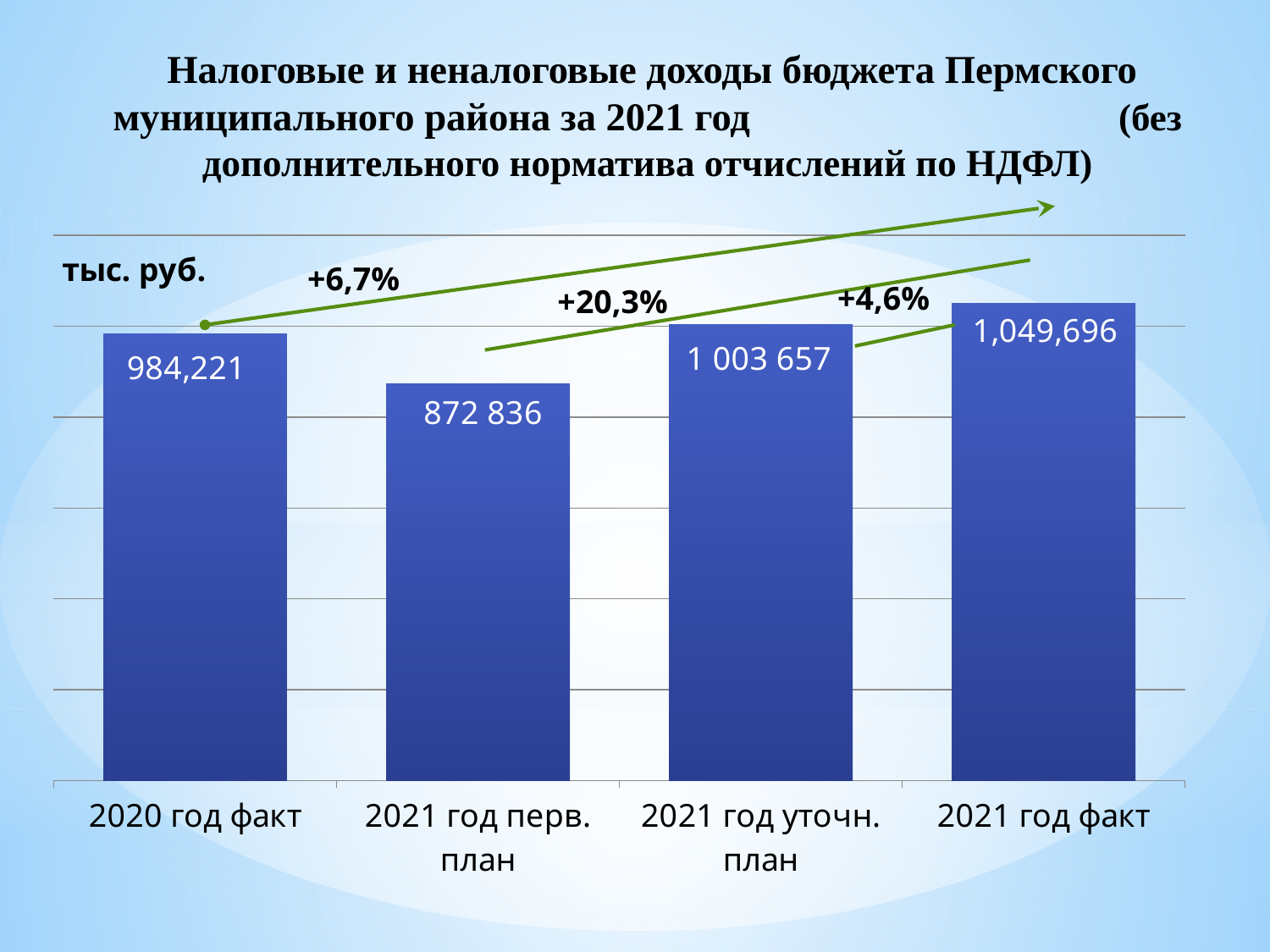
What is the difference between the value for 2021 год факт and the value for 2020 год факт? 65,475 Which is larger, the value for 2020 год факт or the value for 2021 год перв. план? 2020 год факт What unit of measurement is indicated for the chart values? тыс. руб. What is the value for 2021 год перв. план? 872 836 How many bars are shown in the chart? 4 Which category has the lowest value? 2021 год перв. план What is the value for 2021 год уточн. план? 1 003 657 What is the value for 2020 год факт? 984,221 What is the value for 2021 год факт? 1,049,696 What is the difference between the value for 2021 год уточн. план and the value for 2021 год перв. план? 130 821 Which category has the highest value? 2021 год факт What kind of chart is shown on the slide? Bar chart